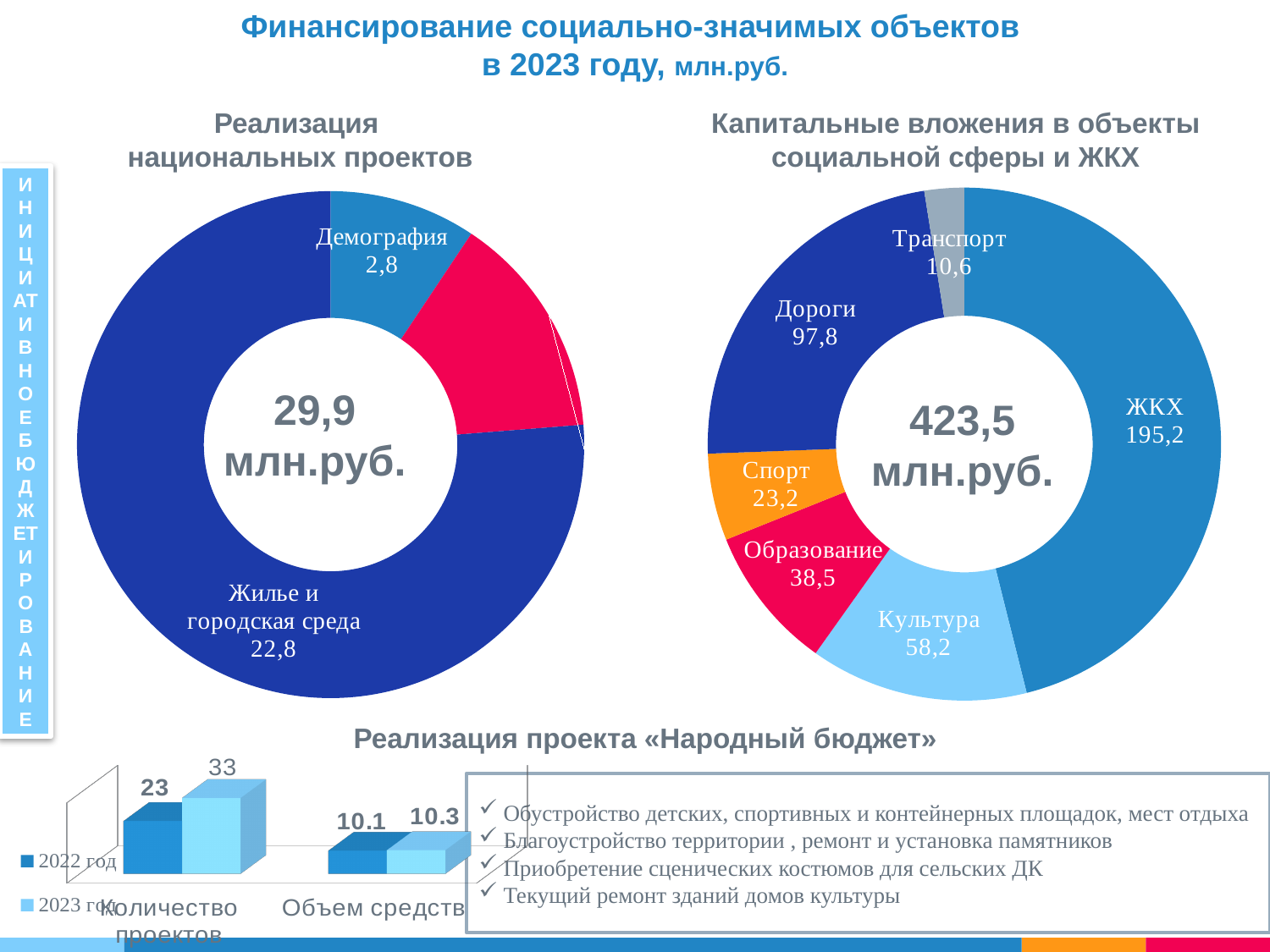
In the chart 'Капитальные вложения в объекты социальной сферы и ЖКХ', what is the value for ЖКХ? 195,2 In the chart 'Реализация проекта «Народный бюджет»', how many series does the legend list? 2 In the chart 'Реализация национальных проектов', what total is shown in the centre of the chart? 29,9 млн.руб. In the chart 'Реализация проекта «Народный бюджет»', what is the value for Количество проектов in 2023 год? 33 In the chart 'Реализация национальных проектов', what is the value for Демография? 2,8 In the chart 'Капитальные вложения в объекты социальной сферы и ЖКХ', what is the difference between Дороги and Культура? 39,6 In the chart 'Капитальные вложения в объекты социальной сферы и ЖКХ', which category has the largest value? ЖКХ In the chart 'Капитальные вложения в объекты социальной сферы и ЖКХ', how many labelled categories are shown? 6 What kind of chart is 'Реализация проекта «Народный бюджет»'? bar chart In the chart 'Капитальные вложения в объекты социальной сферы и ЖКХ', which category has the smallest value? Транспорт In the chart 'Капитальные вложения в объекты социальной сферы и ЖКХ', which is larger: Спорт or Образование? Образование In the chart 'Капитальные вложения в объекты социальной сферы и ЖКХ', what is the value for Образование? 38,5